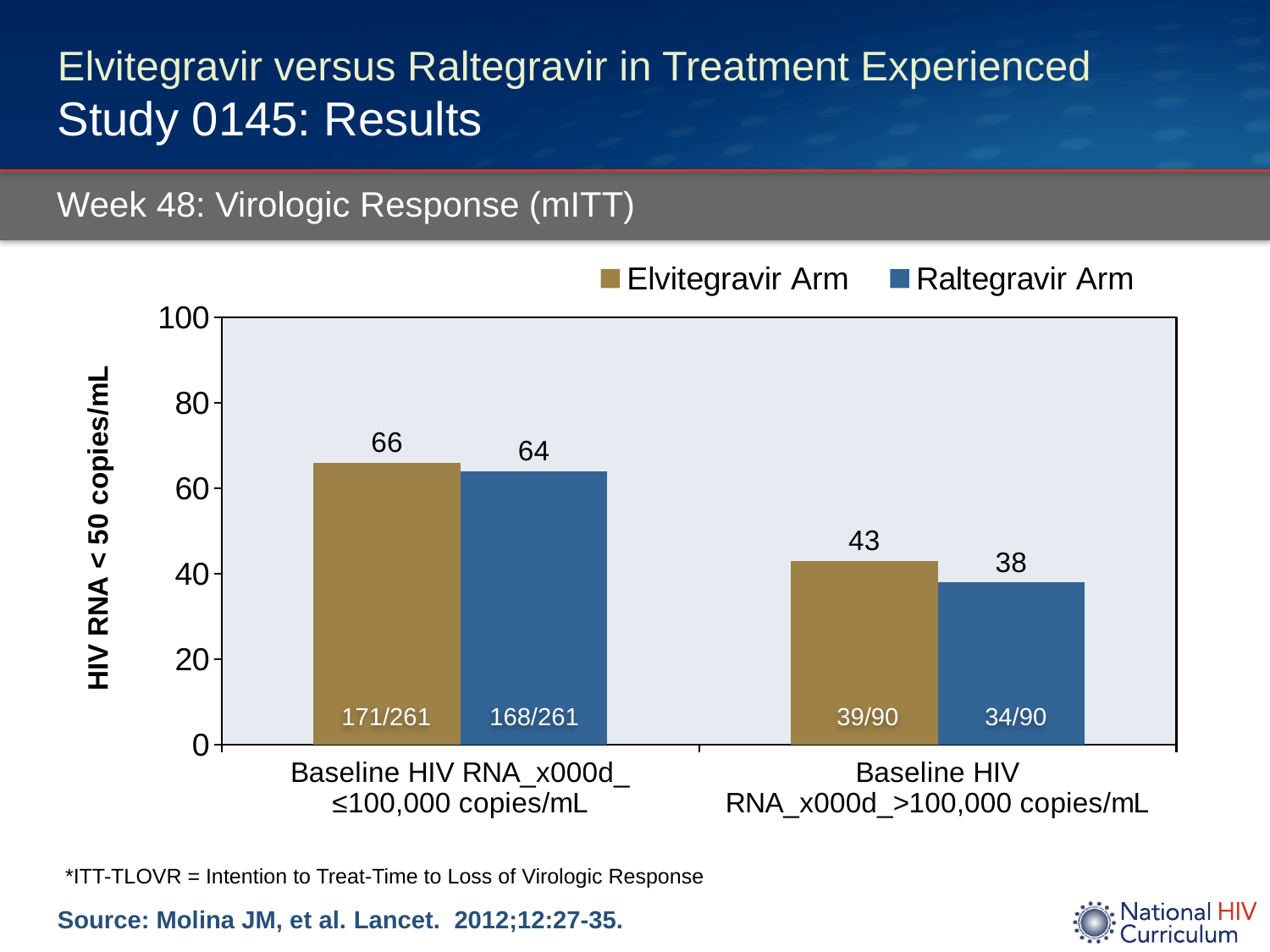
What is the difference between the Elvitegravir Arm value in the ≤100,000 copies/mL category and its value in the >100,000 copies/mL category? 23 What fraction is printed inside the Elvitegravir Arm bar for the Baseline HIV RNA ≤100,000 copies/mL category? 171/261 Which bar has the lowest value on the chart? Raltegravir Arm, Baseline HIV RNA >100,000 copies/mL Is the Raltegravir Arm value in the Baseline HIV RNA >100,000 copies/mL category greater or less than 40? less What is the value for the Raltegravir Arm in the Baseline HIV RNA >100,000 copies/mL category? 38 What is the value for the Elvitegravir Arm in the Baseline HIV RNA >100,000 copies/mL category? 43 Which bar has the highest value on the chart? Elvitegravir Arm, Baseline HIV RNA ≤100,000 copies/mL How many series does the legend list? 2 What is the value for the Elvitegravir Arm in the Baseline HIV RNA ≤100,000 copies/mL category? 66 What kind of chart is shown on the slide? Bar chart What is the difference between the Elvitegravir Arm and Raltegravir Arm values in the Baseline HIV RNA >100,000 copies/mL category? 5 What is the value for the Raltegravir Arm in the Baseline HIV RNA ≤100,000 copies/mL category? 64